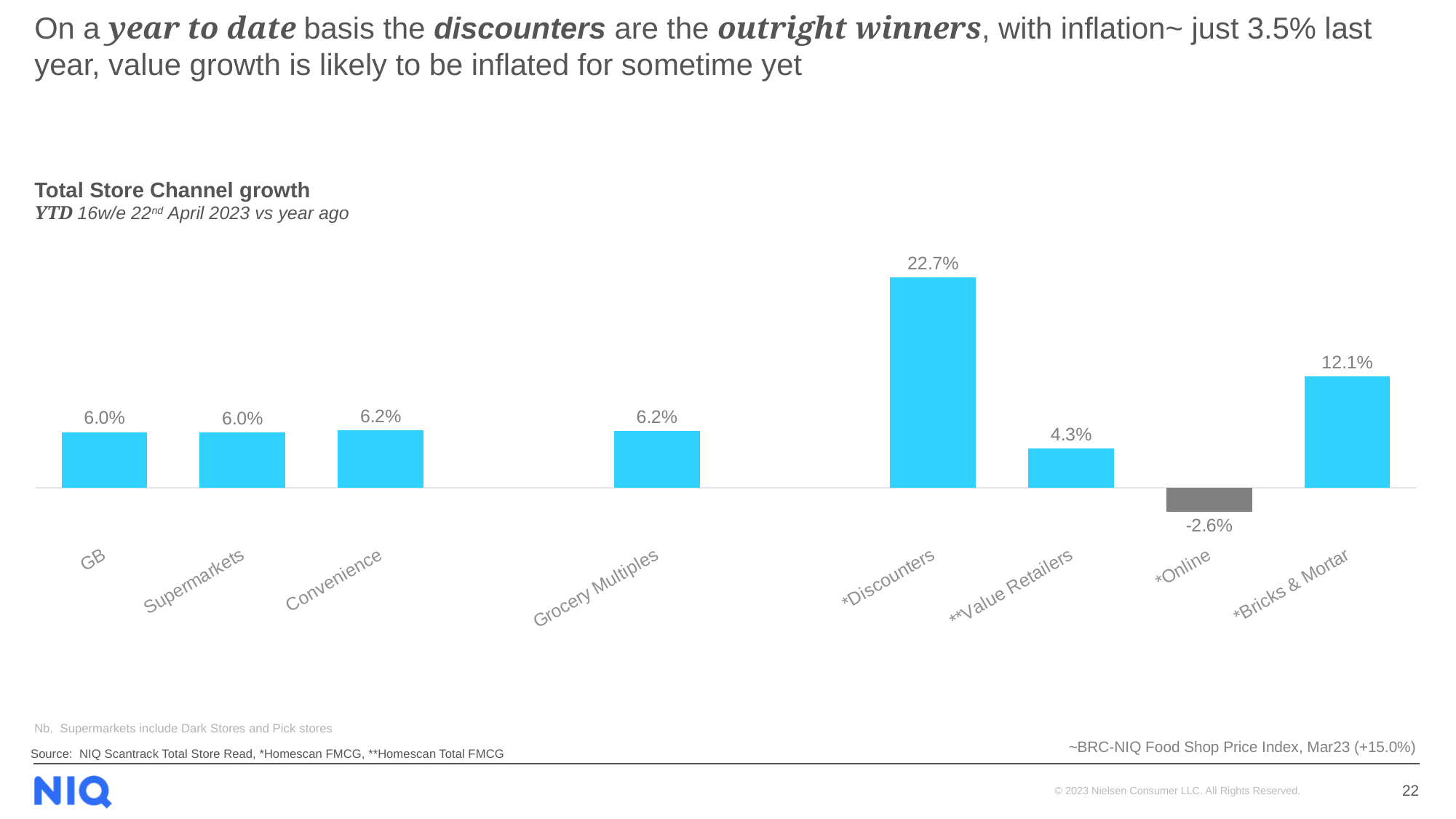
Which is larger, the value for Convenience or the value for **Value Retailers? Convenience What kind of chart is shown on the slide? Bar chart What is the title of the chart? Total Store Channel growth What is the value for **Value Retailers? 4.3% What is the value for *Discounters? 22.7% What is the difference between the values for *Discounters and *Bricks & Mortar? 10.6% Which category has the lowest value? *Online Which category's bar is coloured grey rather than blue? *Online How many categories are shown on the chart? 8 Which category has the highest value? *Discounters What is the value for *Bricks & Mortar? 12.1% What is the value for *Online? -2.6%